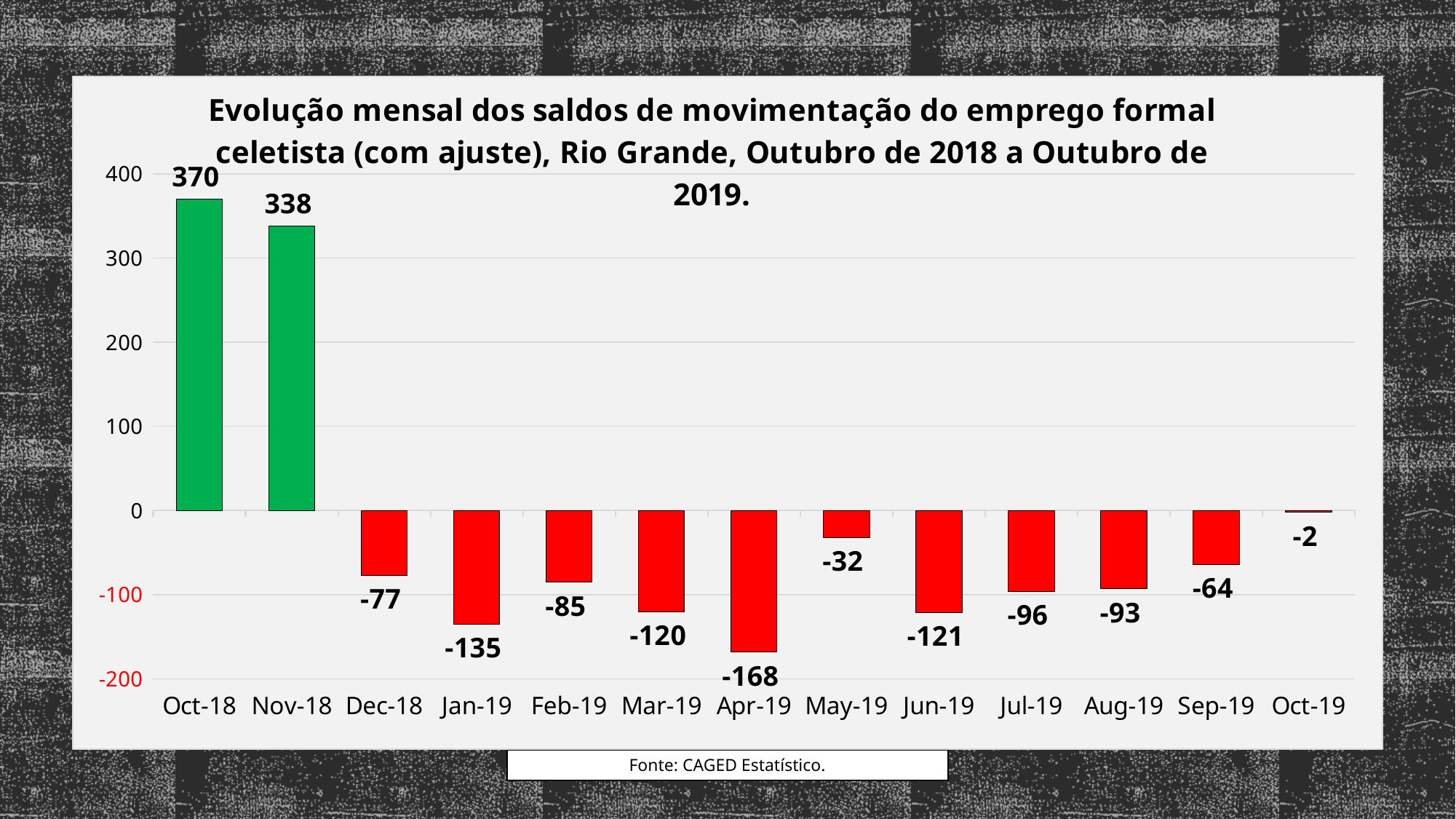
What is the value for Oct-19? -2 How many months have a positive value? 2 How many months are shown on the x axis? 13 What is the value for Oct-18? 370 What is the difference between the values for Oct-18 and Nov-18? 32 Which is larger, the value for Dec-18 or the value for Feb-19? Dec-18 What colour are the bars with negative values? red Is the value for Jan-19 greater or less than -100? less Which month has the lowest value? Apr-19 What is the value for Apr-19? -168 Which month has the highest value? Oct-18 What kind of chart is shown on the slide? bar chart